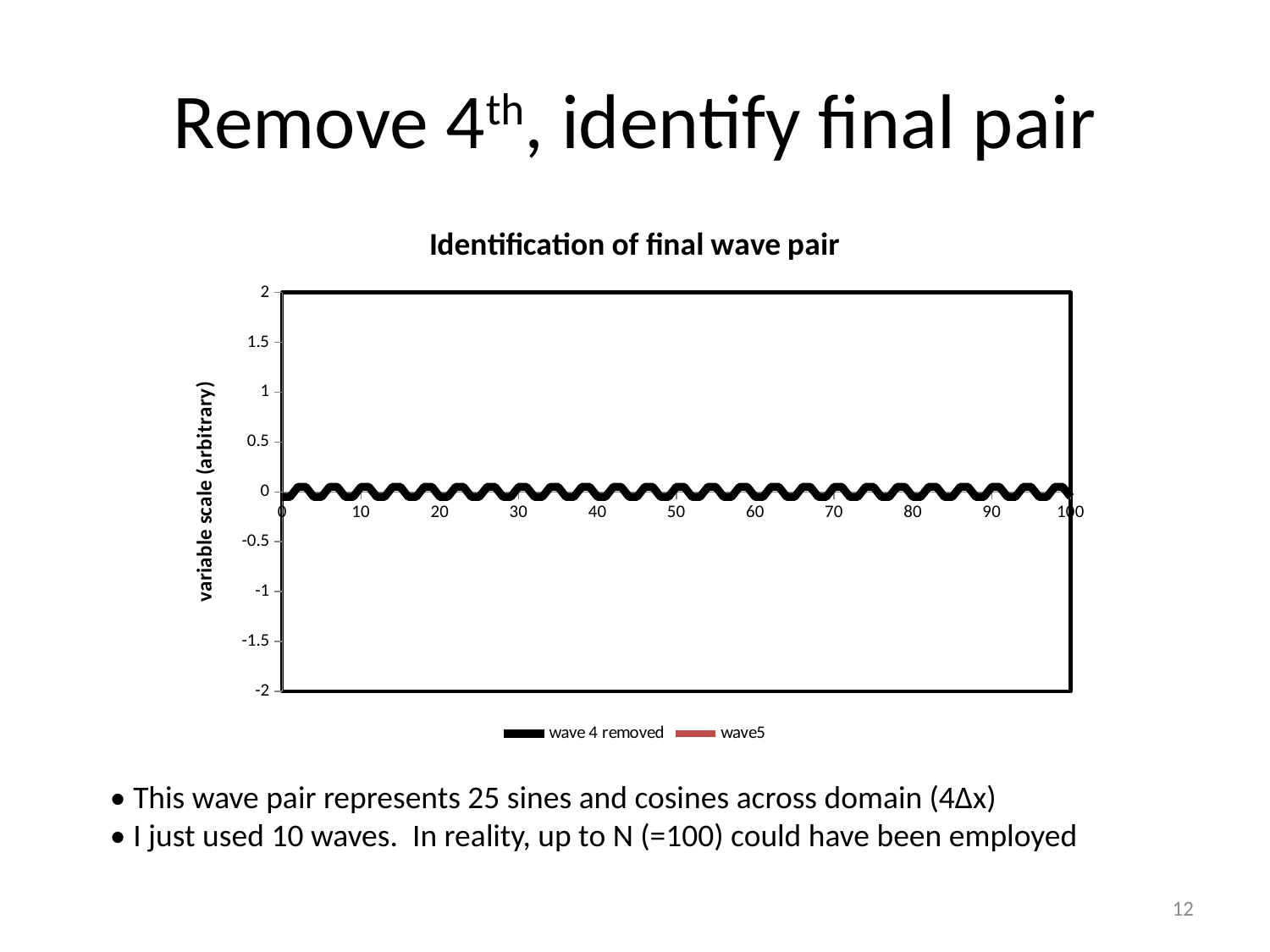
How many series does the chart legend list? 2 Is the plotted value at x = 50 greater or less than 1? less What is the label on the vertical axis of the chart? variable scale (arbitrary) What kind of chart is shown on the slide? line chart Is the plotted value at x = 20 greater or less than 0.5? less Across the horizontal axis from 0 to 100, do the plotted values rise, fall, or stay roughly level around zero? stay roughly level around zero What is the lowest value shown on the vertical axis of the chart? -2 Is the plotted value at x = 50 greater or less than -1? greater What are the two series named in the chart legend? wave 4 removed, wave5 What is the highest value shown on the vertical axis of the chart? 2 What is the largest value shown on the horizontal axis of the chart? 100 What is the title of the chart? Identification of final wave pair